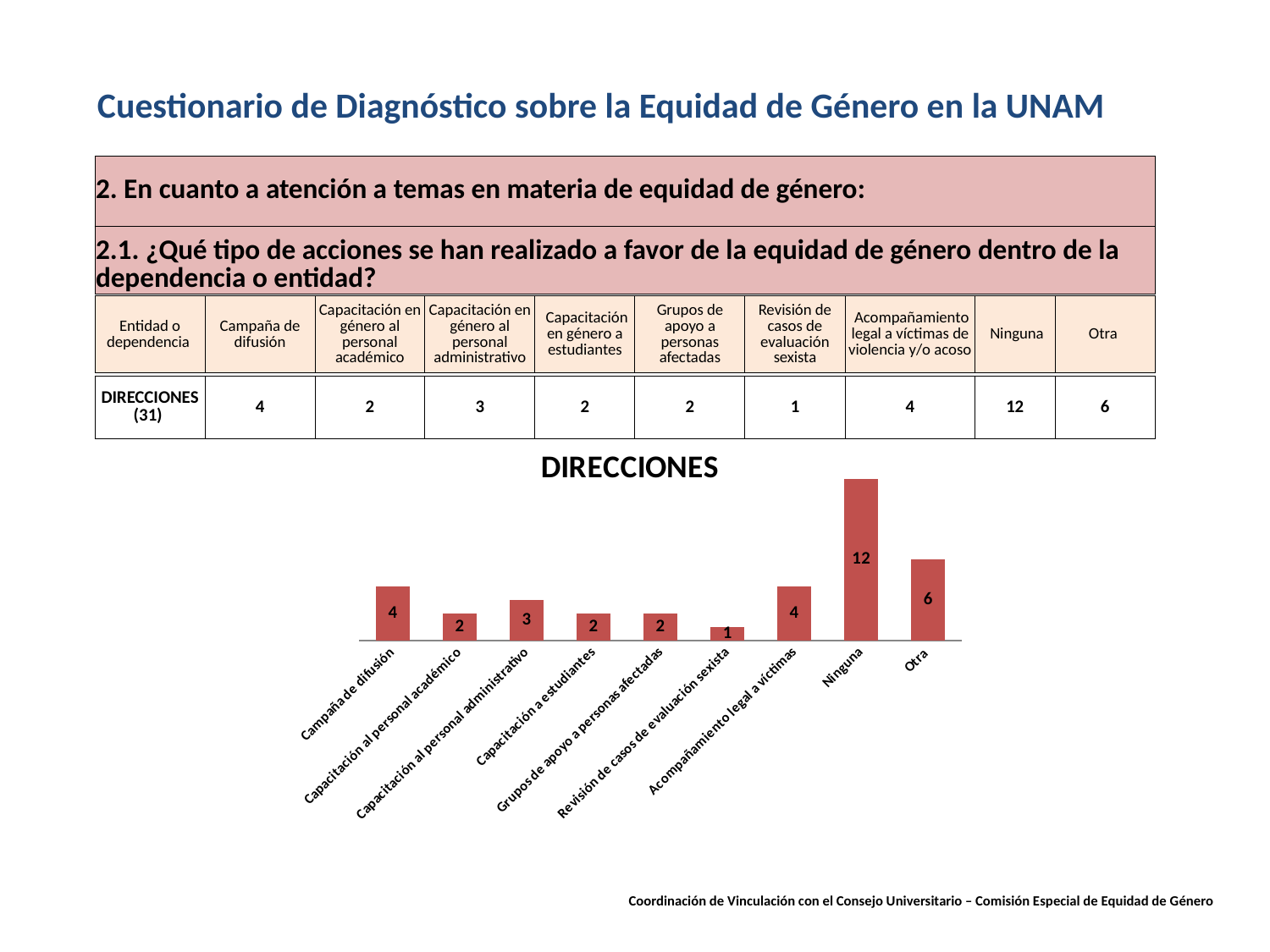
Which category has the highest value in the DIRECCIONES chart? Ninguna How many categories are shown in the DIRECCIONES chart? 9 What kind of chart is the DIRECCIONES chart? bar chart What is the value for Ninguna in the DIRECCIONES chart? 12 What is the title of the chart on the slide? DIRECCIONES Which is larger in the DIRECCIONES chart: Capacitación al personal administrativo or Capacitación a estudiantes? Capacitación al personal administrativo What is the value for Campaña de difusión in the DIRECCIONES chart? 4 Which category has the lowest value in the DIRECCIONES chart? Revisión de casos de evaluación sexista What is the value for Otra in the DIRECCIONES chart? 6 What is the value for Acompañamiento legal a víctimas in the DIRECCIONES chart? 4 What is the difference between the values for Campaña de difusión and Revisión de casos de evaluación sexista in the DIRECCIONES chart? 3 What is the difference between the values for Ninguna and Otra in the DIRECCIONES chart? 6